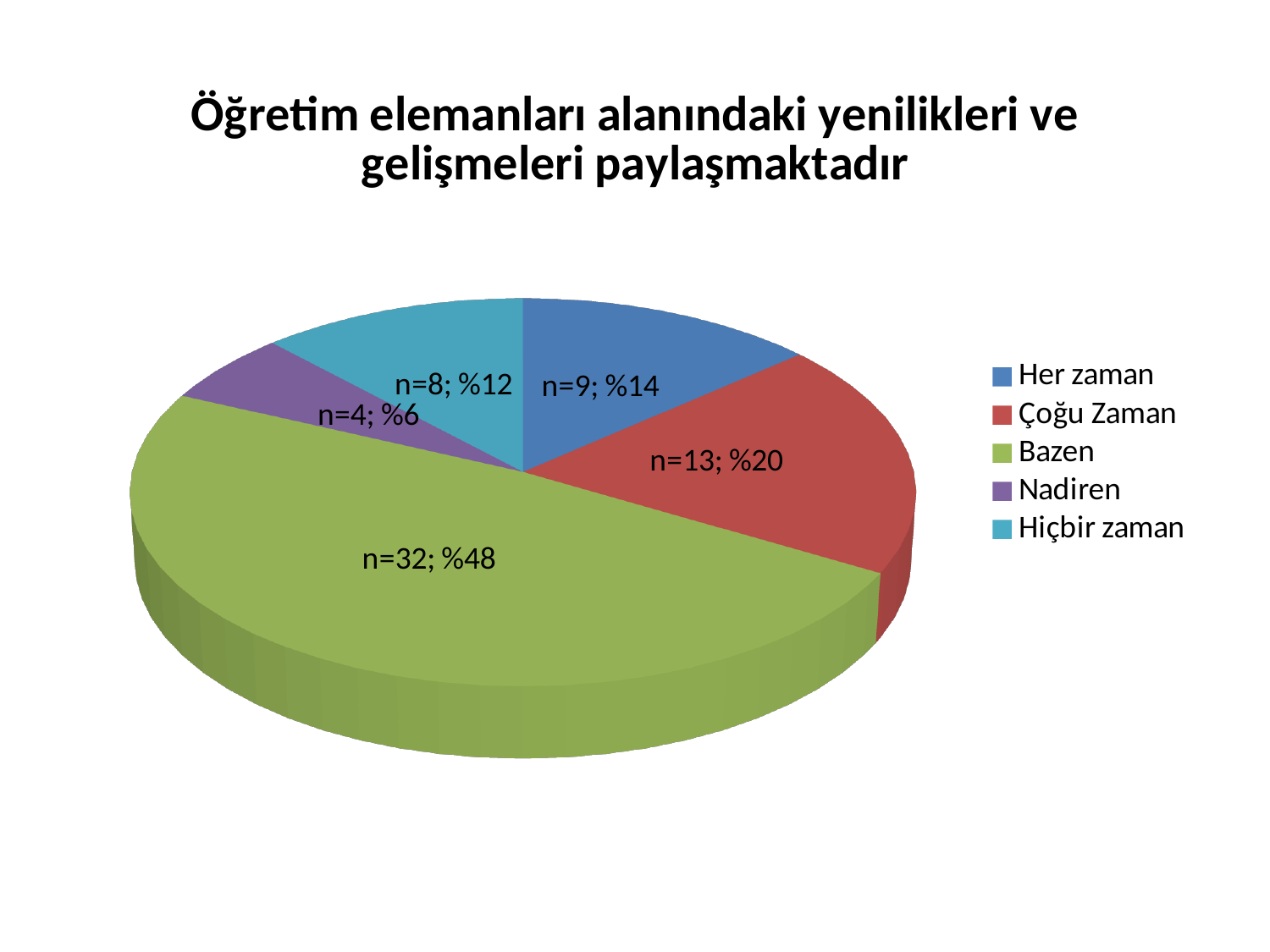
What is the data label for the 'Bazen' slice? n=32; %48 Which category has the largest slice? Bazen What is the data label for the 'Hiçbir zaman' slice? n=8; %12 What is the data label for the 'Nadiren' slice? n=4; %6 What is the data label for the 'Çoğu Zaman' slice? n=13; %20 What is the difference in n between 'Bazen' and 'Çoğu Zaman'? 19 What is the data label for the 'Her zaman' slice? n=9; %14 Which category has the smallest slice? Nadiren Which is larger, the 'Her zaman' slice or the 'Hiçbir zaman' slice? Her zaman How many categories does the legend list? 5 What percentage share of the pie does 'Çoğu Zaman' have? %20 What kind of chart is shown on the slide? pie chart